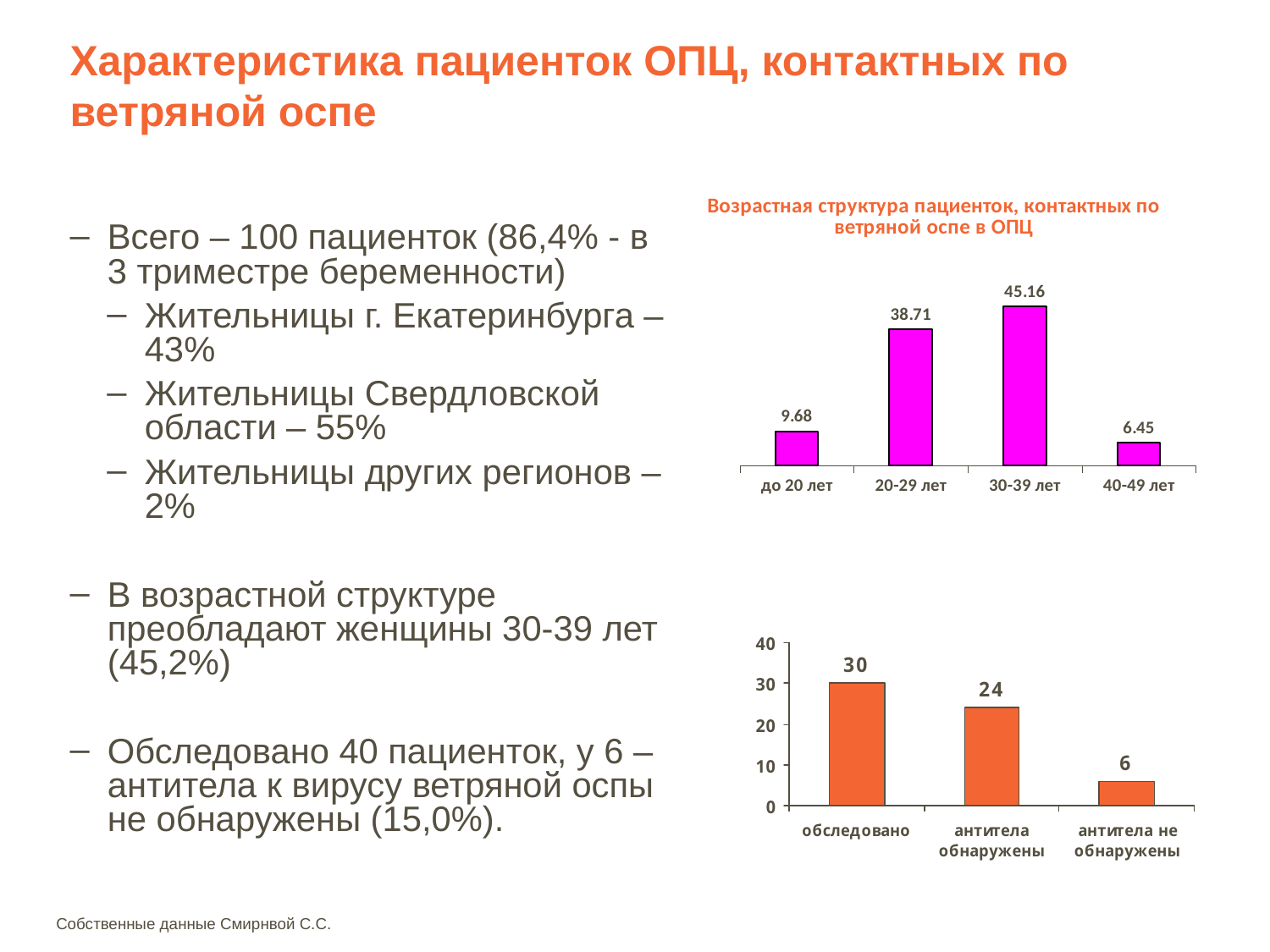
In the top chart 'Возрастная структура пациенток, контактных по ветряной оспе в ОПЦ', which age group has the highest value? 30-39 лет In the bottom chart on the right, what is the value for 'антитела обнаружены'? 24 In the top chart 'Возрастная структура пациенток, контактных по ветряной оспе в ОПЦ', what is the difference between the values for 30-39 лет and 20-29 лет? 6.45 In the bottom chart on the right, what is the value for 'антитела не обнаружены'? 6 What colour are the bars in the top chart 'Возрастная структура пациенток, контактных по ветряной оспе в ОПЦ'? Magenta What type of chart is the bottom chart on the right? Bar chart In the top chart 'Возрастная структура пациенток, контактных по ветряной оспе в ОПЦ', what is the value for 30-39 лет? 45.16 In the bottom chart on the right, what is the difference between 'обследовано' and 'антитела обнаружены'? 6 In the top chart 'Возрастная структура пациенток, контактных по ветряной оспе в ОПЦ', what is the value for до 20 лет? 9.68 In the top chart 'Возрастная структура пациенток, контактных по ветряной оспе в ОПЦ', which age group has the lowest value? 40-49 лет In the top chart 'Возрастная структура пациенток, контактных по ветряной оспе в ОПЦ', how many age groups are shown? 4 In the top chart 'Возрастная структура пациенток, контактных по ветряной оспе в ОПЦ', which is larger: the value for до 20 лет or for 40-49 лет? до 20 лет